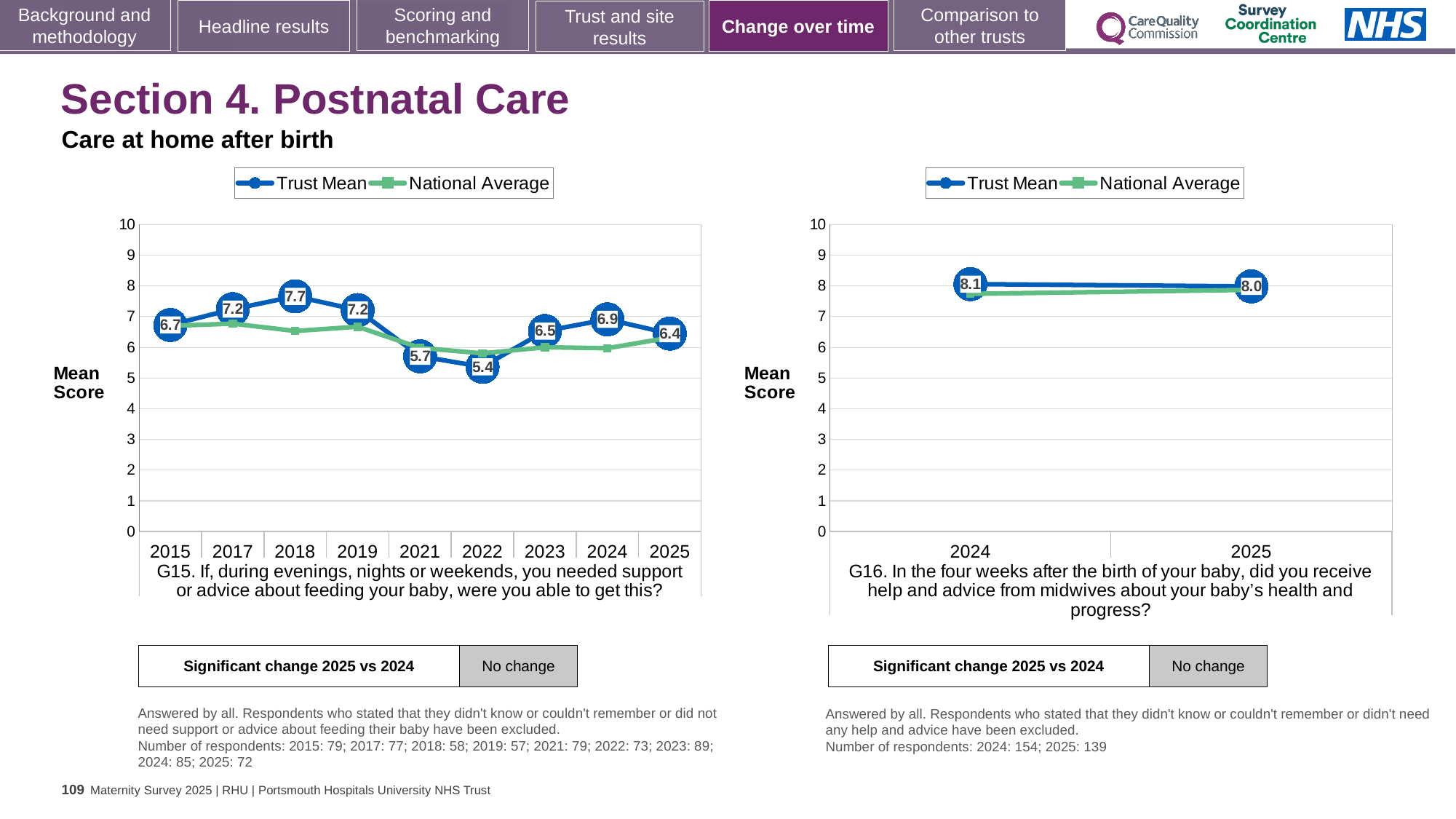
In the right chart (G16), what is the difference between the Trust Mean scores for 2024 and 2025? 0.1 In the left chart (G15), which year has the highest Trust Mean score? 2018 How many years are plotted on the x axis of the left chart (G15)? 9 In the left chart (G15), what is the Trust Mean score for 2022? 5.4 In the left chart (G15), what is the Trust Mean score for 2018? 7.7 In the left chart (G15), is the National Average for 2018 greater or less than 7? less How many series does the legend of the right chart (G16) list? 2 In the right chart (G16), what is the Trust Mean score for 2024? 8.1 In the left chart (G15), what is the difference between the Trust Mean scores for 2024 and 2025? 0.5 In the left chart (G15), which year has the lowest Trust Mean score? 2022 In the left chart (G15), is the Trust Mean score higher in 2015 or in 2021? 2015 What type of chart is the left chart (G15)? Line chart